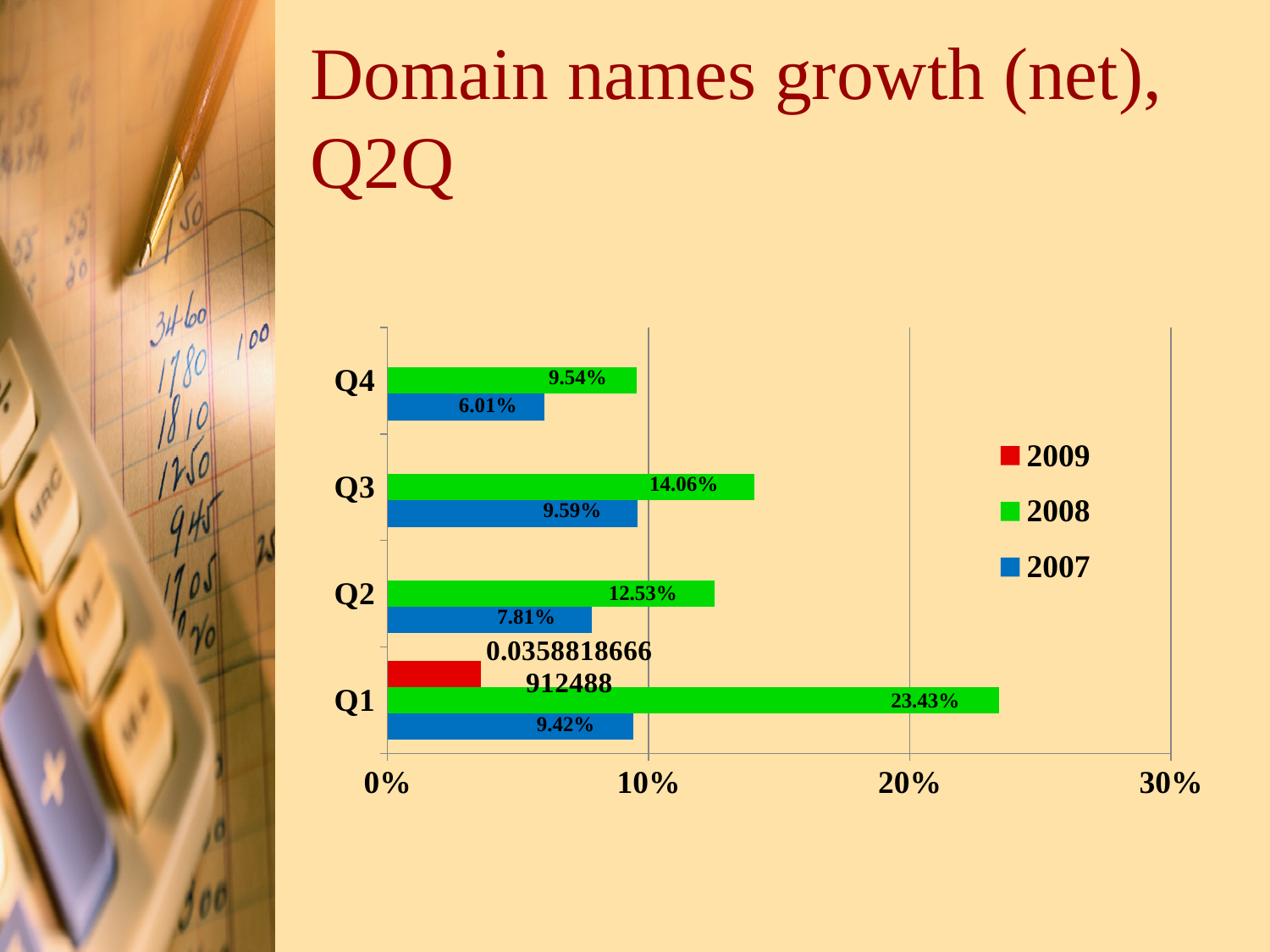
How many quarters are shown on the chart? 4 What kind of chart is shown on the slide? Bar chart Is the 2008 value for Q1 greater or less than 20%? greater What is the 2007 value for Q4? 6.01% What is the difference between the 2008 and 2007 values for Q3? 4.47% Which quarter has the highest 2008 value? Q1 What is the 2008 value for Q2? 12.53% How many series does the legend list? 3 What is the 2007 value for Q3? 9.59% Which quarter has the lowest 2007 value? Q4 What is the 2008 value for Q1? 23.43% Which is larger for Q2, the 2008 value or the 2007 value? 2008